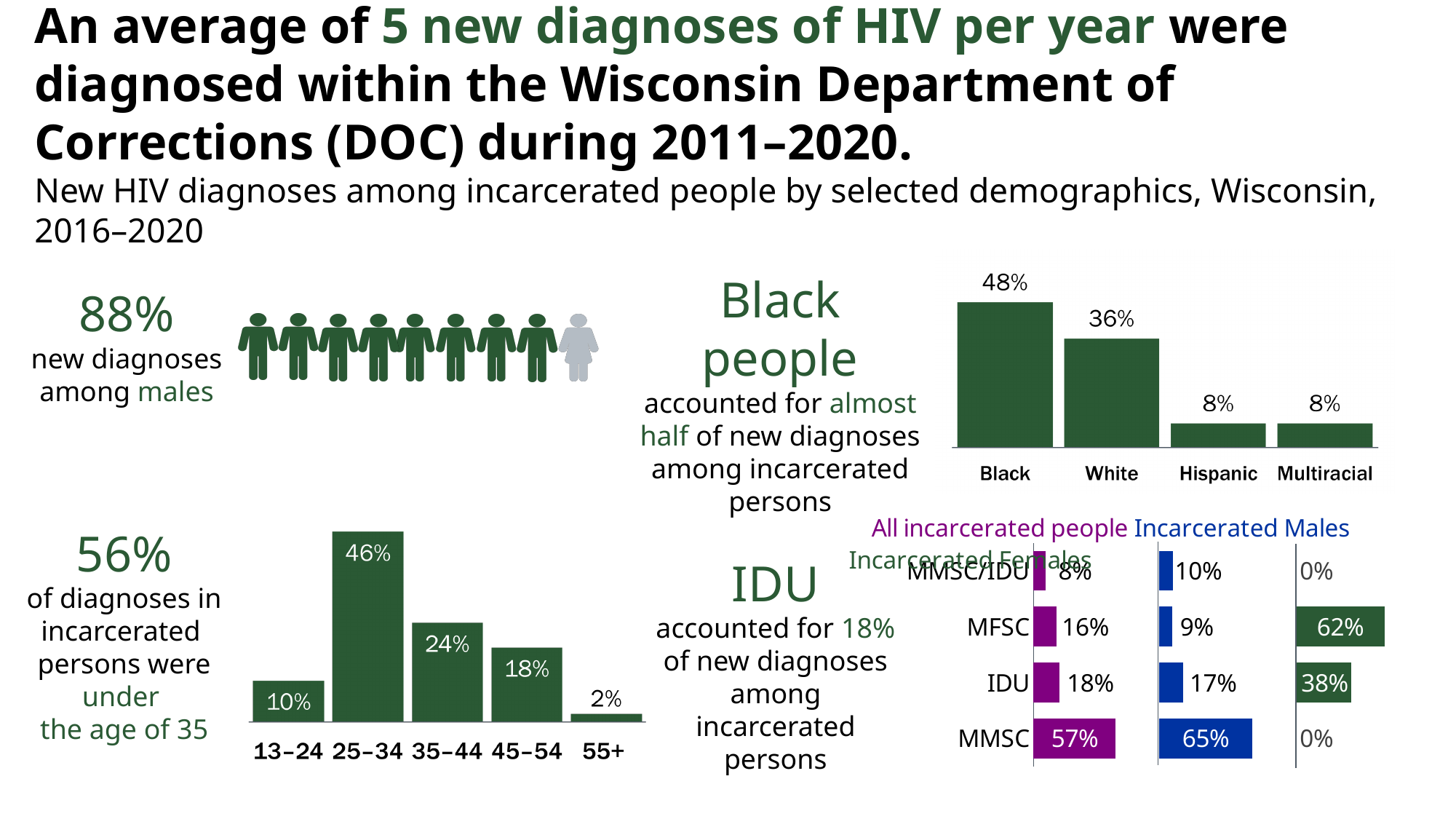
In the age group bar chart at the bottom left, what is the value for the 35–44 age group? 24% In the race/ethnicity bar chart at the top right, what is the difference between the Black and White values? 12% What type of chart is the age group chart at the bottom left? Bar chart In the transmission category chart at the bottom right, what is the MFSC value for Incarcerated Females? 62% In the age group bar chart at the bottom left, what is the difference between the 25–34 and 35–44 values? 22% In the race/ethnicity bar chart at the top right, which category has the highest value? Black In the age group bar chart at the bottom left, which is larger: the value for 13–24 or the value for 45–54? 45–54 In the race/ethnicity bar chart at the top right, what percentage of new diagnoses were among Black people? 48% In the age group bar chart at the bottom left, which age group has the lowest value? 55+ In the race/ethnicity bar chart at the top right, how many categories are shown? 4 In the transmission category chart at the bottom right, what is the MMSC value for Incarcerated Males? 65% In the transmission category chart at the bottom right, how many series does the legend list? 3